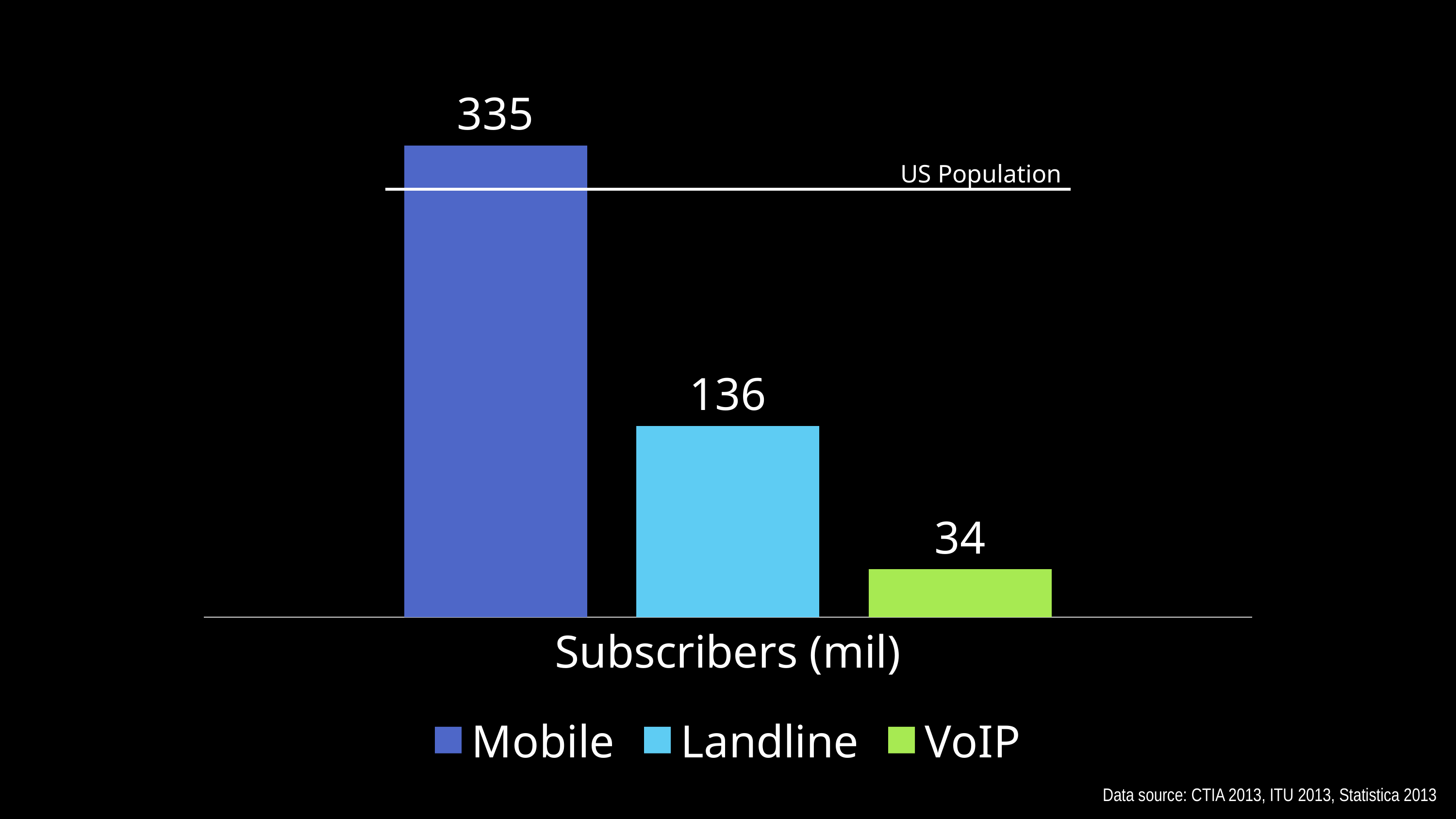
What is the x-axis label of the chart? Subscribers (mil) What is the difference between Landline and VoIP subscribers (mil)? 102 Which series has the lowest number of subscribers? VoIP What is the value for Mobile subscribers (mil)? 335 What is the label of the horizontal reference line drawn across the chart? US Population What kind of chart is shown on the slide? Bar chart Which series has the highest number of subscribers? Mobile How many series does the legend list? 3 What is the difference between Mobile and Landline subscribers (mil)? 199 What is the value for VoIP subscribers (mil)? 34 What is the value for Landline subscribers (mil)? 136 Which is larger, Landline or VoIP subscribers? Landline